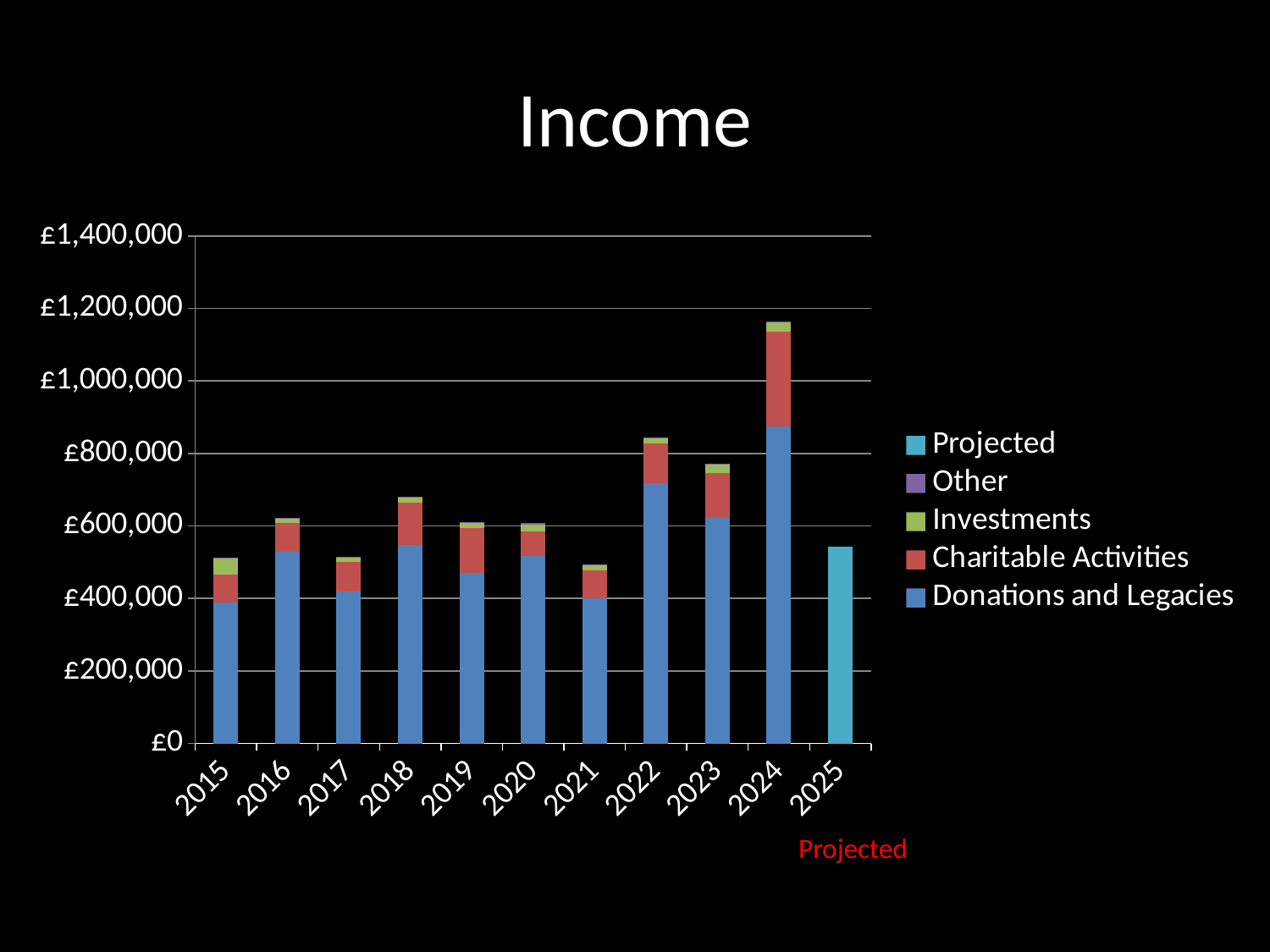
Is the projected income for 2025 greater or less than £600,000? less What kind of chart is shown on the slide? Stacked bar chart Which year has the highest total income? 2024 Is the total income for 2021 greater or less than £600,000? less Is the Donations and Legacies value for 2024 greater or less than £800,000? greater How many years are shown along the x axis? 11 Which year has the larger total income, 2022 or 2023? 2022 How many series does the legend list? 5 What is the title of the chart? Income Which series is shown at the bottom of each stacked bar? Donations and Legacies